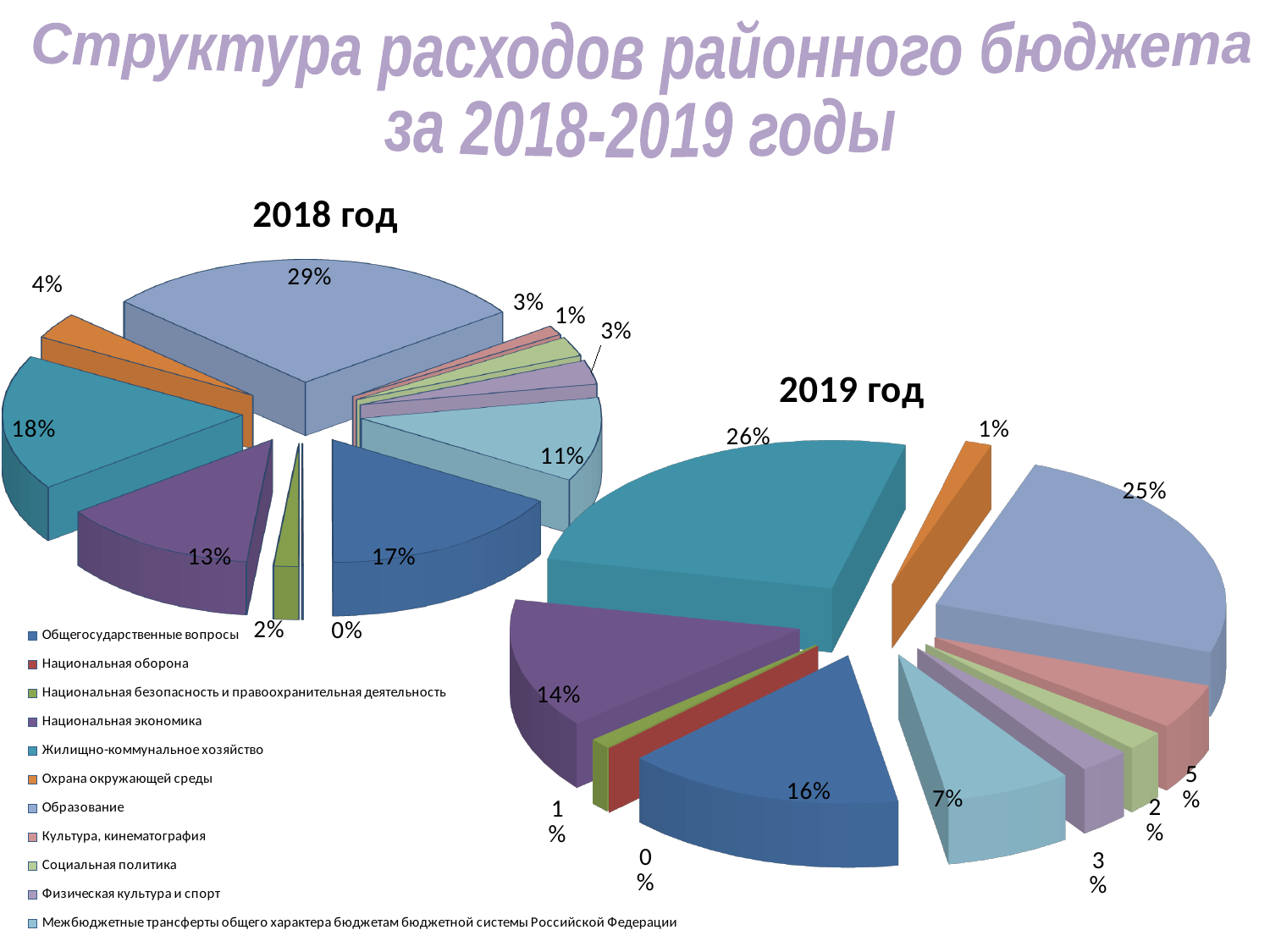
In the "2018 год" chart, what share does Национальная экономика have? 13% In the "2018 год" chart, what share does Образование have? 29% What kind of chart is used for the "2018 год" chart? Pie chart In the "2019 год" chart, what share does Жилищно-коммунальное хозяйство have? 26% In the "2018 год" chart, which is larger: Жилищно-коммунальное хозяйство or Национальная экономика? Жилищно-коммунальное хозяйство In the "2019 год" chart, what share does Общегосударственные вопросы have? 16% By how many percentage points did the share of Образование change from the "2018 год" chart (29%) to the "2019 год" chart (25%)? 4 percentage points In the "2019 год" chart, what is the difference between the shares of Жилищно-коммунальное хозяйство and Образование? 1 percentage point In the "2019 год" chart, which category has the largest share? Жилищно-коммунальное хозяйство In the "2018 год" chart, which category has the largest share? Образование What is the title of the slide? Структура расходов районного бюджета за 2018-2019 годы How many categories does the legend list? 11